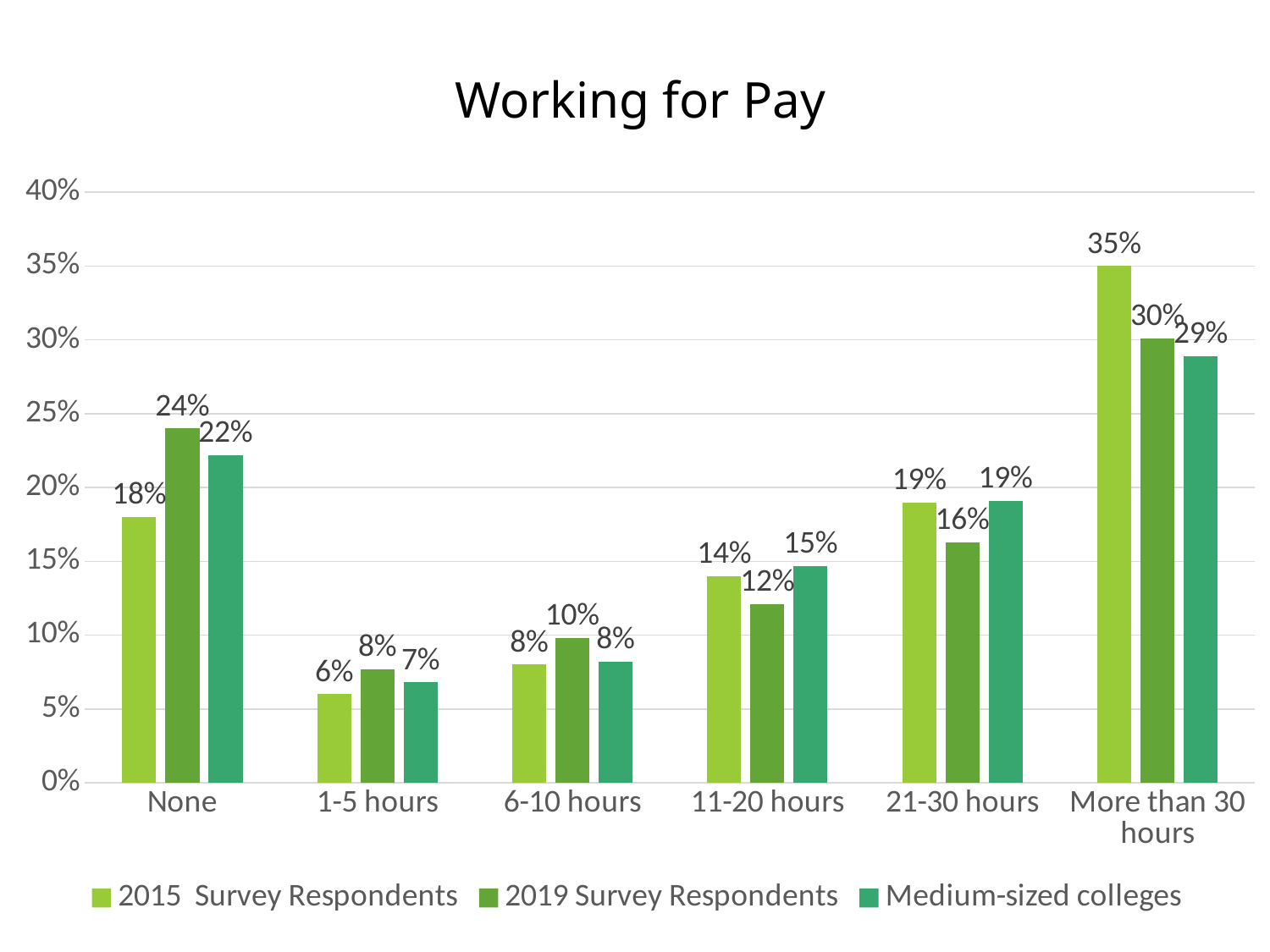
How many categories are shown on the x axis? 6 In the 21-30 hours category, which is larger: 2015 Survey Respondents or 2019 Survey Respondents? 2015 Survey Respondents Which category has the lowest value for 2019 Survey Respondents? 1-5 hours Is the value for 2019 Survey Respondents in the More than 30 hours category greater or less than 25%? greater What is the title of the chart? Working for Pay Which category has the highest value for 2015 Survey Respondents? More than 30 hours What is the value for 2015 Survey Respondents in the None category? 18% What is the difference between the 2015 Survey Respondents and 2019 Survey Respondents values in the None category? 6% How many series does the legend list? 3 What is the value for Medium-sized colleges in the More than 30 hours category? 29% What kind of chart is shown on the slide? bar chart What is the value for 2019 Survey Respondents in the 11-20 hours category? 12%